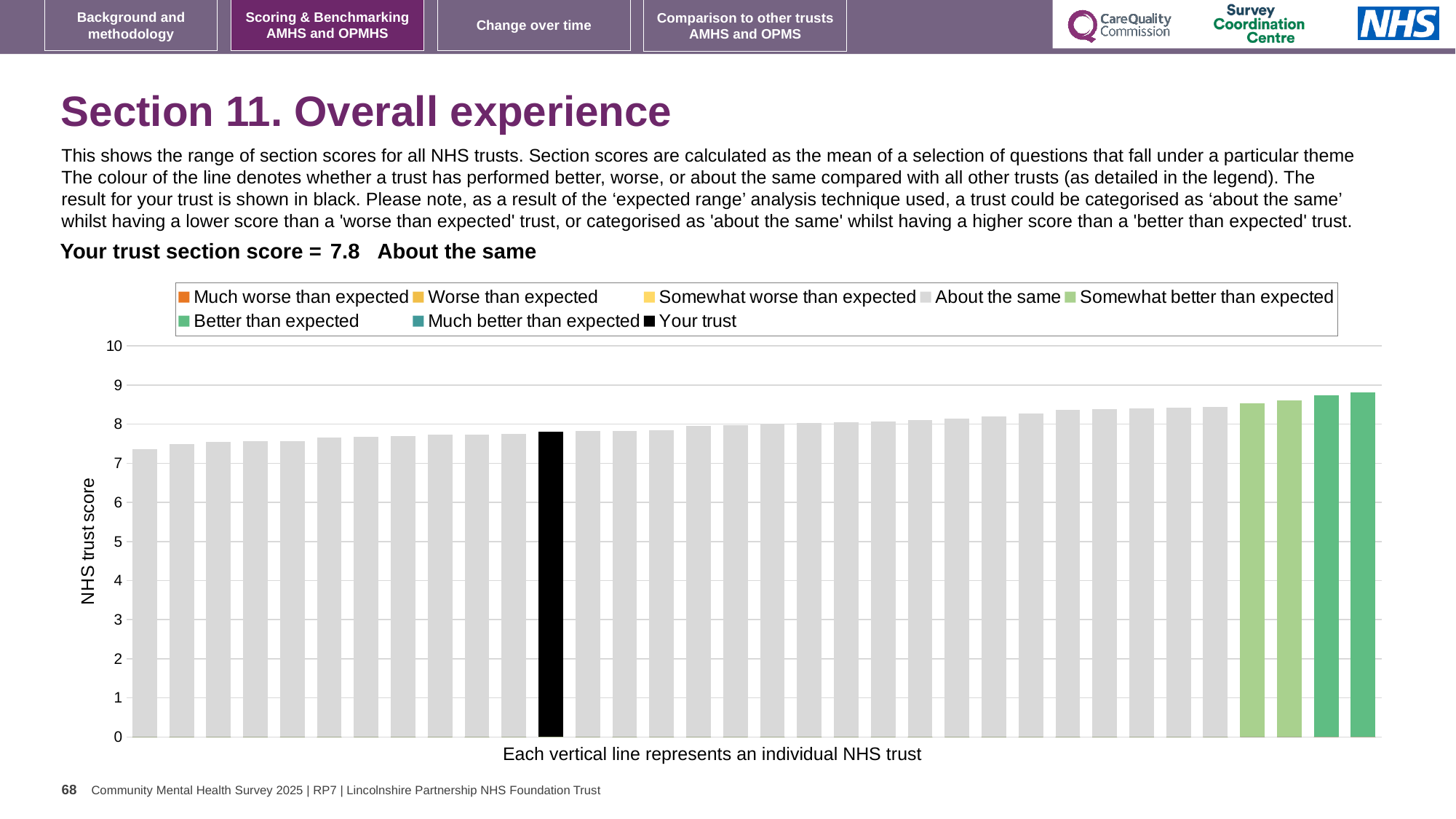
What kind of chart is shown on the slide? bar chart Which is larger, the rightmost bar or the black 'Your trust' bar? the rightmost bar How many bars are coloured as 'Better than expected' (darker green)? 2 What is the section score for your trust shown on the slide? 7.8 What is the label on the vertical axis of the chart? NHS trust score Is the value of the tallest bar (rightmost) greater or less than 8? greater Do the bar values rise or fall moving from left to right along the x axis? rise Which category is your trust placed in for this section? About the same How many entries does the chart legend list? 8 Is the value of the shortest bar (leftmost) greater or less than 8? less Is the value for your trust (the black bar) greater or less than 7? greater How many bars are coloured as 'Somewhat better than expected' (light green)? 2